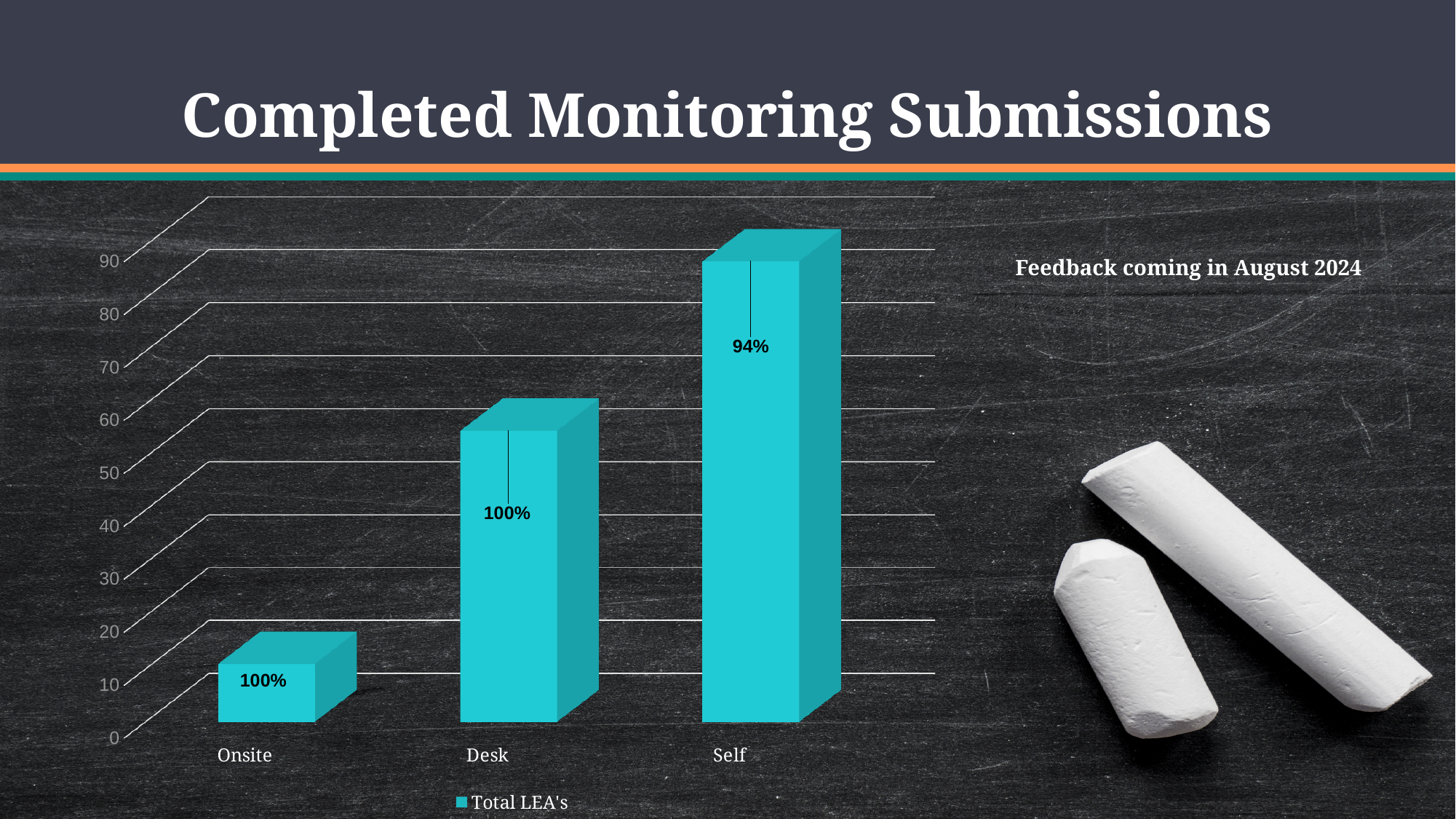
Which category has the shortest bar in the chart? Onsite How many series does the legend list? 1 What is the difference between the percentage labels on the Desk bar and the Self bar? 6% What is the data label shown on the Self bar? 94% Which bar is taller, Desk or Self? Self Is the height of the Desk bar greater or less than 50 on the axis? greater How many categories are shown on the x axis of the chart? 3 What is the data label shown on the Desk bar? 100% What kind of chart is shown on the slide? Bar chart What is the data label shown on the Onsite bar? 100% Is the height of the Onsite bar greater or less than 20 on the axis? less Which category has the tallest bar in the chart? Self